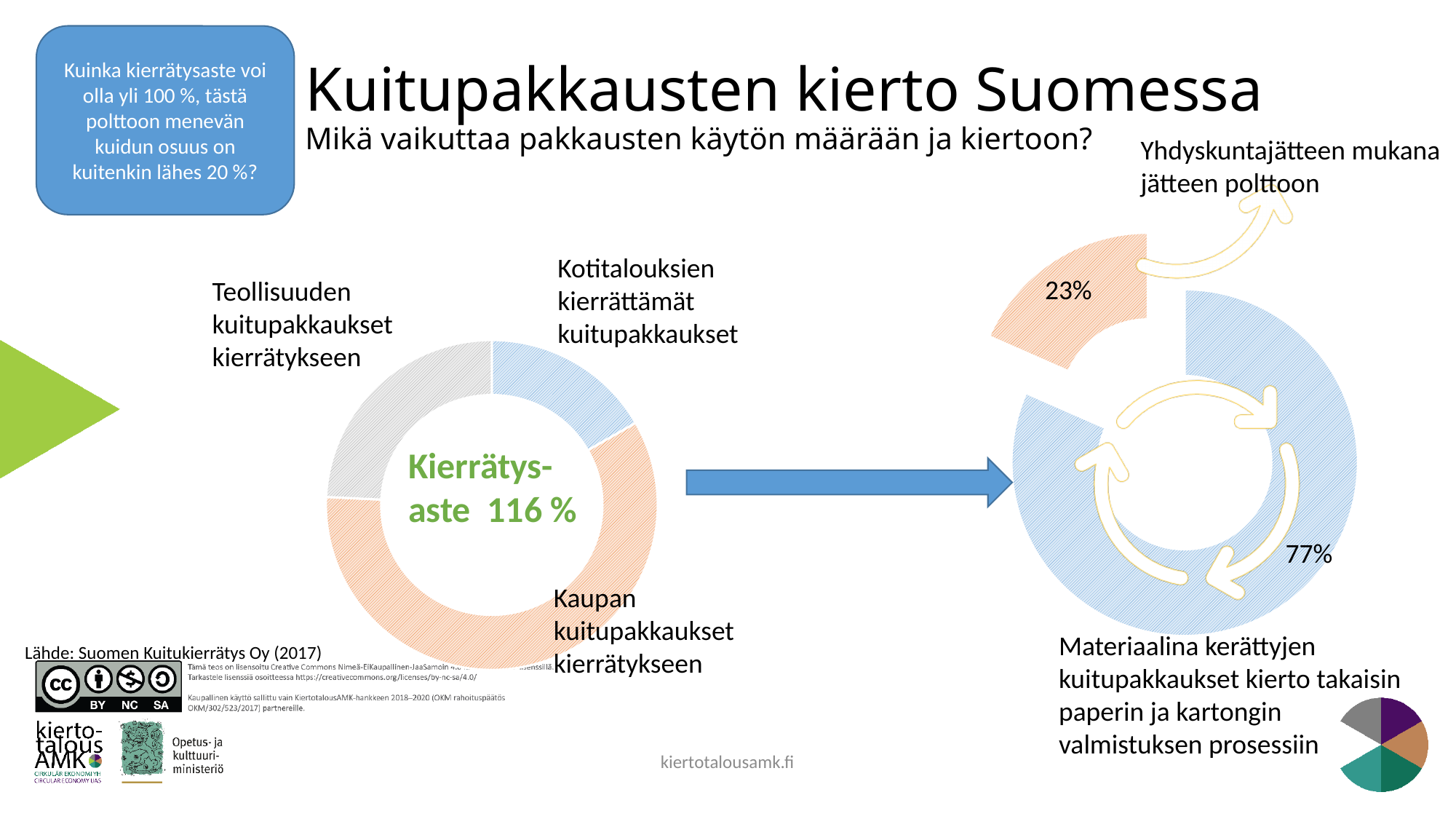
In the right-hand chart, what colour is the 23% segment? Orange What kind of chart is the left-hand chart with the text "Kierrätysaste 116 %" in its centre? Donut chart In the left-hand donut chart, which segment is the smallest? Kotitalouksien kierrättämät kuitupakkaukset How many segments does the left-hand donut chart have? 3 In the left-hand donut chart, which is larger: the segment for Teollisuuden kuitupakkaukset kierrätykseen or the segment for Kotitalouksien kierrättämät kuitupakkaukset? Teollisuuden kuitupakkaukset kierrätykseen What recycling rate (kierrätysaste) is printed in the centre of the left-hand donut chart? 116 % In the left-hand donut chart, which segment is the largest? Kaupan kuitupakkaukset kierrätykseen In the right-hand chart, what percentage is shown for the share going to waste incineration with municipal waste (Yhdyskuntajätteen mukana jätteen polttoon)? 23% In the right-hand chart, what is the difference between the 77% share and the 23% share? 54% What is the title of the slide containing the charts? Kuitupakkausten kierto Suomessa In the right-hand chart, what percentage is shown for the fibre packaging collected as material and returned to paper and board production? 77% In the right-hand chart, which share is larger: the one going to incineration or the one returned to paper and board production? The one returned to paper and board production (77%)